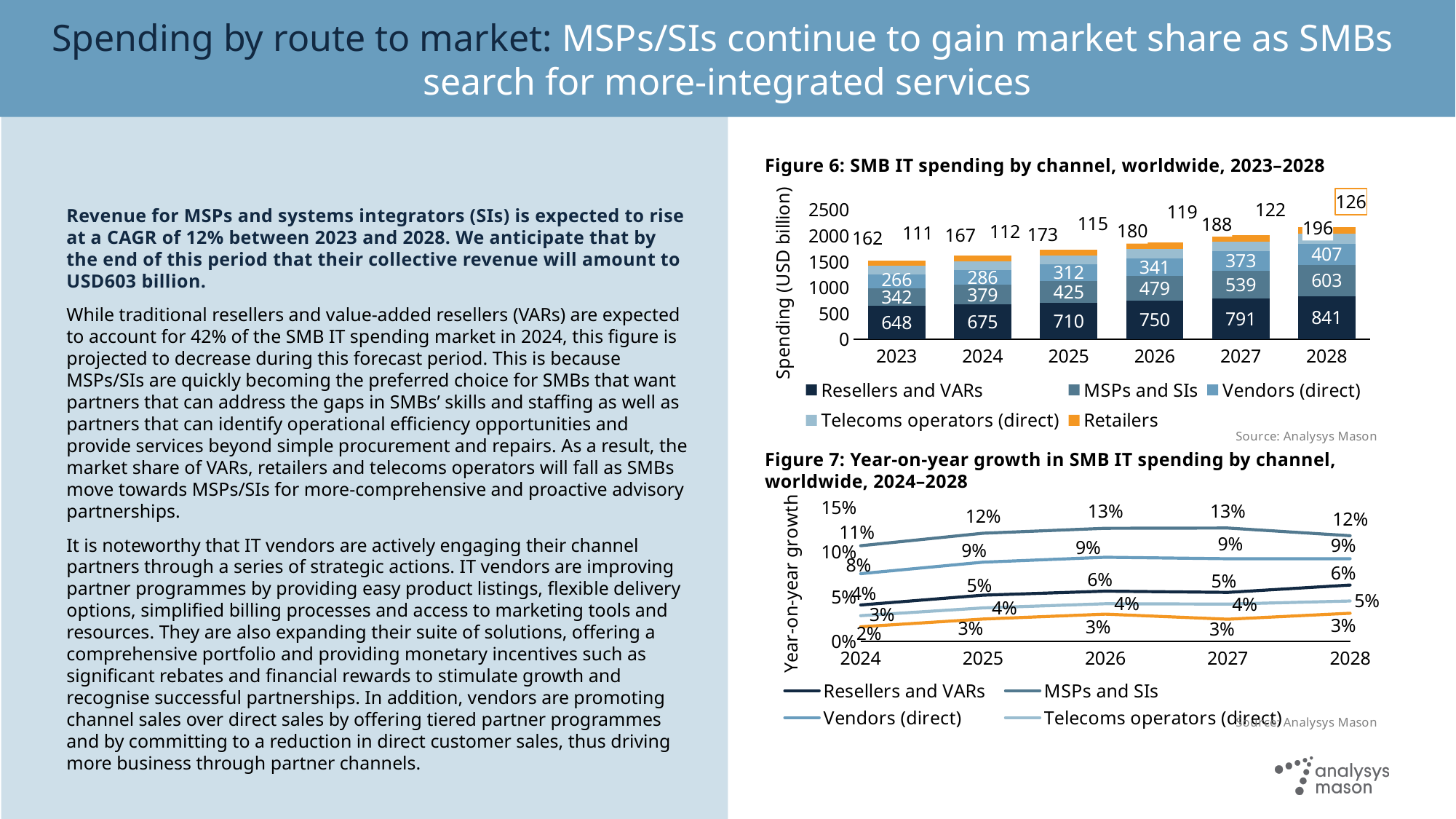
In Figure 6 (SMB IT spending by channel), what is the total spending across all channels in 2023? 1529 How many series does the legend of Figure 6 (SMB IT spending by channel) list? 5 In Figure 6 (SMB IT spending by channel), by how much does the Resellers and VARs value in 2028 exceed its value in 2023? 193 In Figure 6 (SMB IT spending by channel), what is the value for MSPs and SIs in 2028? 603 In Figure 6 (SMB IT spending by channel), what is the value for Resellers and VARs in 2025? 710 In Figure 7 (Year-on-year growth), what is the growth for MSPs and SIs in 2026? 13% What kind of chart is Figure 7 (Year-on-year growth in SMB IT spending by channel)? Line chart In Figure 7 (Year-on-year growth), which channel has the highest growth in 2024? MSPs and SIs How many years are shown on the x axis of Figure 6 (SMB IT spending by channel)? 6 In Figure 6 (SMB IT spending by channel), what is the value for Retailers in 2026? 119 In Figure 6 (SMB IT spending by channel), which is larger in 2027: Vendors (direct) or Telecoms operators (direct)? Vendors (direct) What kind of chart is Figure 6 (SMB IT spending by channel)? Stacked bar chart